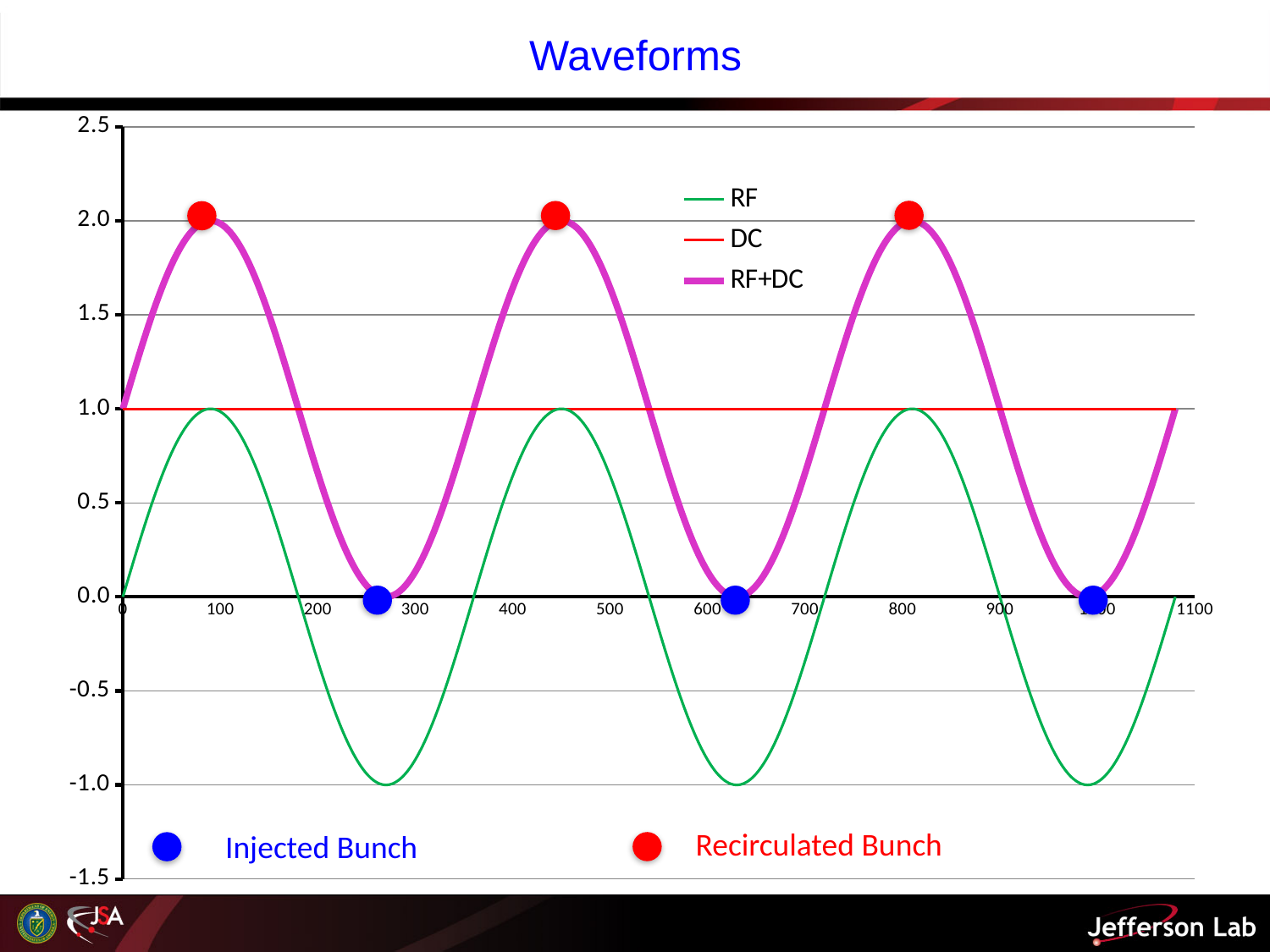
What is the minimum value reached by the RF+DC series? 0.0 What kind of chart is shown on the slide? line chart What are the three series named in the legend? RF, DC, RF+DC Which series reaches the highest peak value, RF or RF+DC? RF+DC How many blue 'Injected Bunch' markers are plotted on the chart? 3 How many series does the legend list? 3 What is the minimum value reached by the RF series? -1.0 What is the maximum value reached by the RF+DC series? 2.0 How many red 'Recirculated Bunch' markers are plotted on the chart? 3 What is the title of the slide? Waveforms What constant value does the DC series hold across the whole x axis? 1.0 Is the peak value of the RF series greater or less than 1.5? less